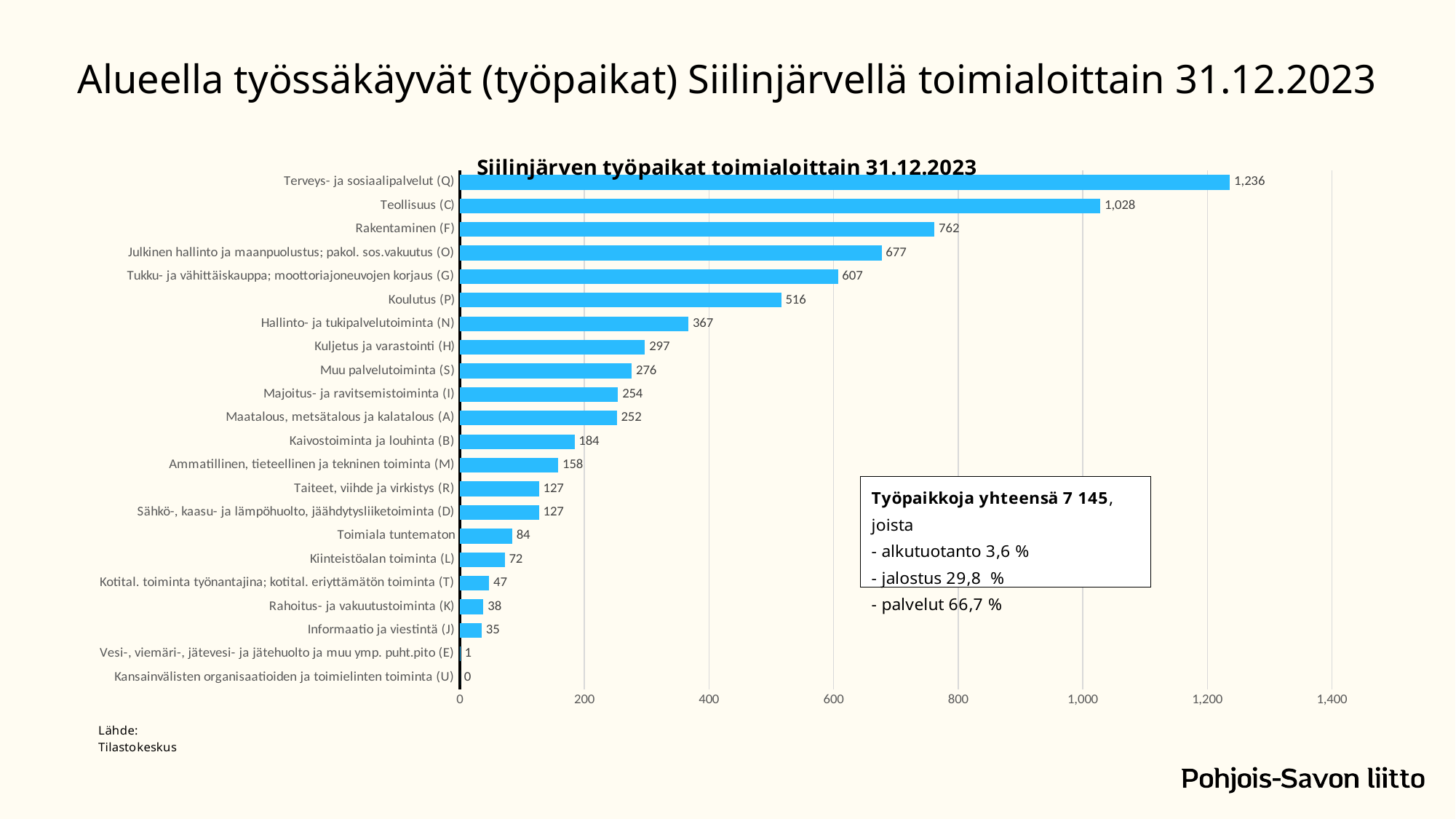
What is the value for Kiinteistöalan toiminta (L)? 72 Which category has the lowest value? Kansainvälisten organisaatioiden ja toimielinten toiminta (U) Is the value for Tukku- ja vähittäiskauppa; moottoriajoneuvojen korjaus (G) greater or less than 400? greater What is the difference between Rakentaminen (F) and Koulutus (P)? 246 How many categories are shown in the chart? 22 What is the title of the chart? Siilinjärven työpaikat toimialoittain 31.12.2023 Which category has the highest value? Terveys- ja sosiaalipalvelut (Q) What is the difference between Terveys- ja sosiaalipalvelut (Q) and Teollisuus (C)? 208 What kind of chart is shown on the slide? bar chart Which is larger, Hallinto- ja tukipalvelutoiminta (N) or Kuljetus ja varastointi (H)? Hallinto- ja tukipalvelutoiminta (N) What is the value for Koulutus (P)? 516 What is the value for Teollisuus (C)? 1,028